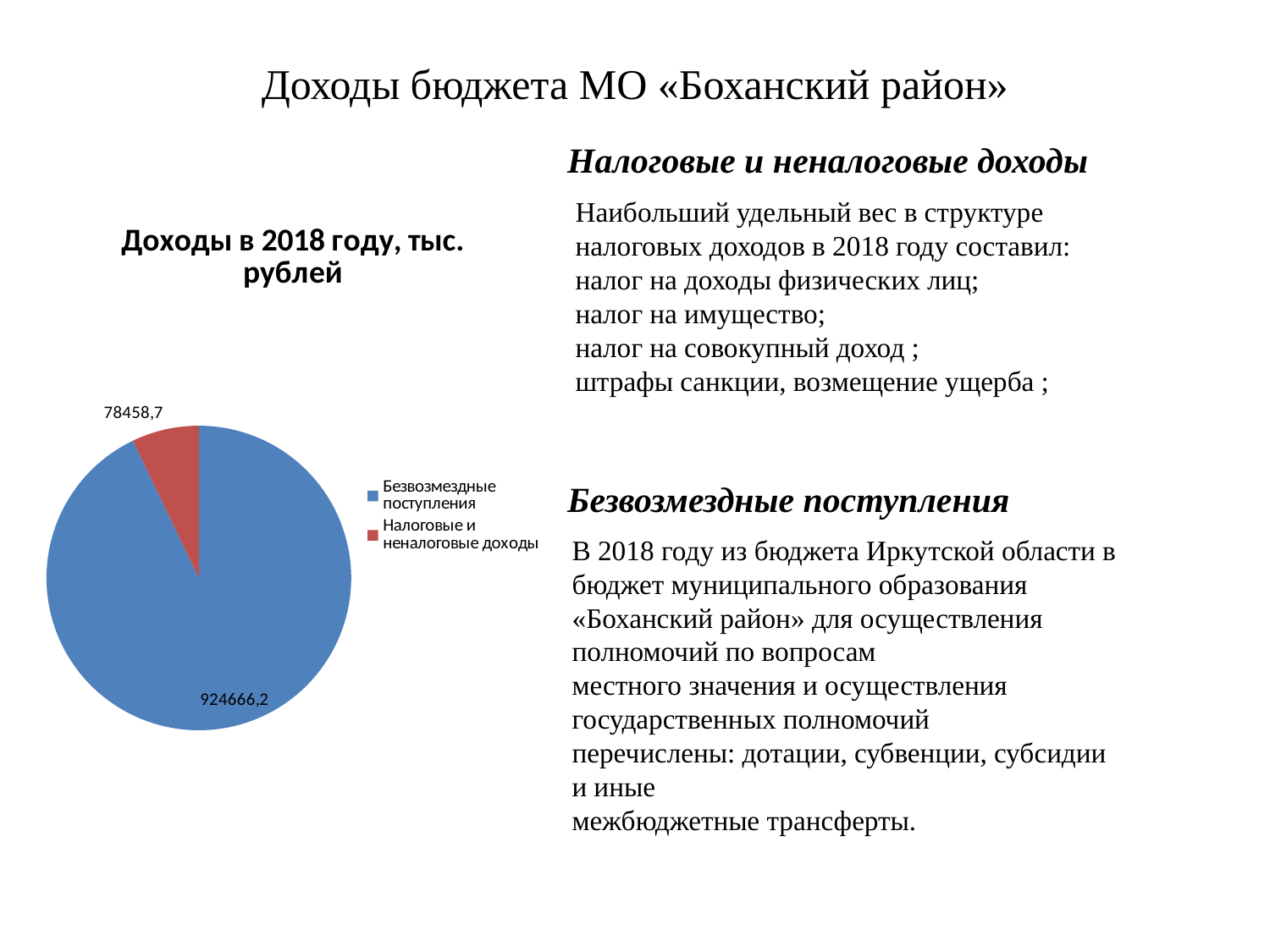
What is the total of the two values shown in the pie chart? 1003124,9 What is the value for Налоговые и неналоговые доходы in the pie chart? 78458,7 Which category has the largest slice in the pie chart? Безвозмездные поступления What kind of chart is shown on the slide? Pie chart How many slices does the pie chart have? 2 Which is larger: Безвозмездные поступления or Налоговые и неналоговые доходы? Безвозмездные поступления How many entries does the legend of the pie chart list? 2 Which category has the smallest slice in the pie chart? Налоговые и неналоговые доходы What is the difference between the values for Безвозмездные поступления and Налоговые и неналоговые доходы? 846207,5 What is the title of the chart? Доходы в 2018 году, тыс. рублей What colour is the slice for Налоговые и неналоговые доходы? Red What is the value for Безвозмездные поступления in the pie chart? 924666,2